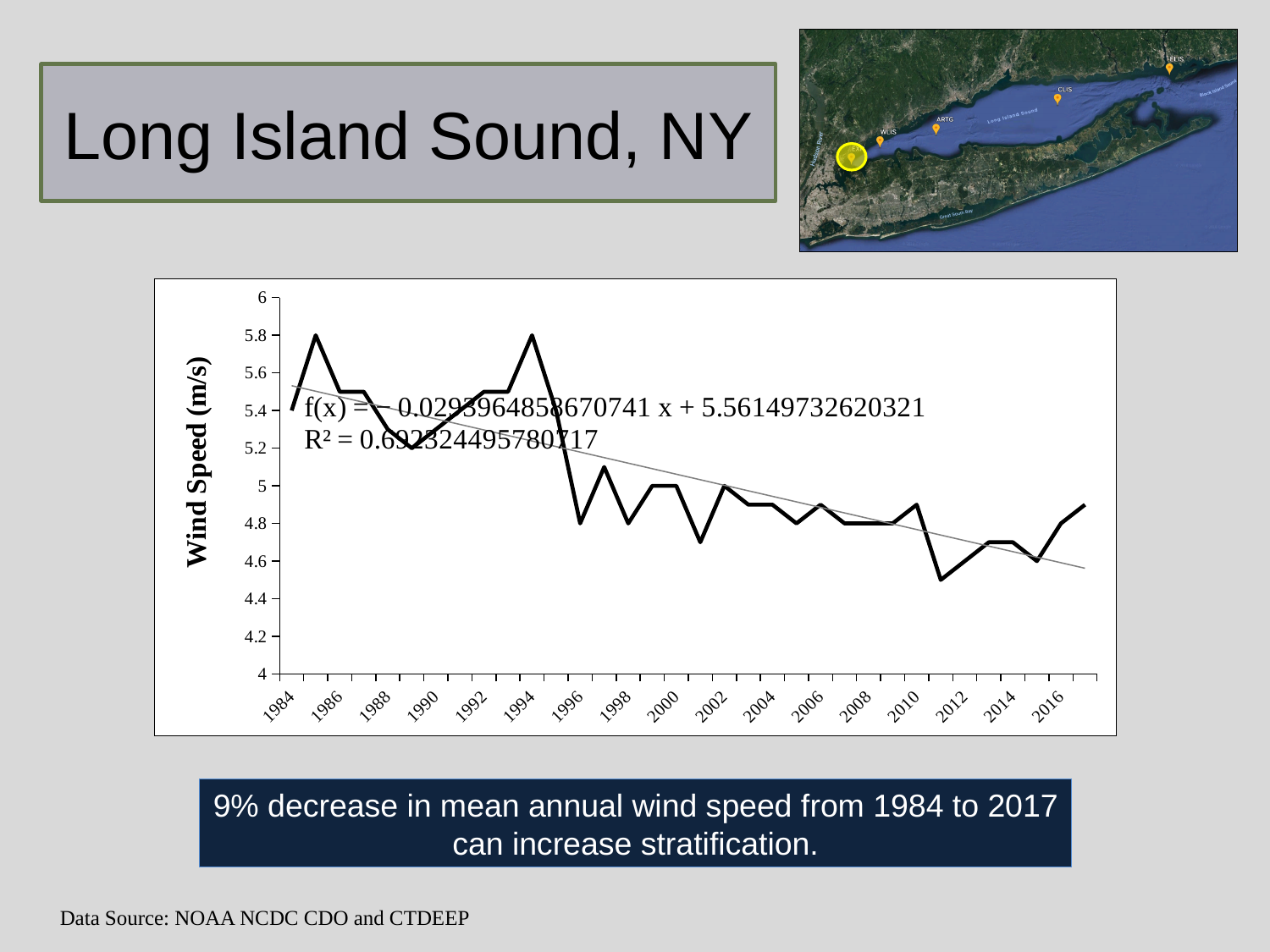
What kind of chart is shown on the slide? line chart Which year has the higher wind speed, 1985 or 2011? 1985 Overall, do the wind speed values rise or fall from 1984 to 2017? fall Which year has the lowest wind speed on the chart? 2011 Is the wind speed for 2016 greater or less than 5? less Is the wind speed for 1985 greater or less than 5.6? greater Is the wind speed for 1989 greater or less than 5? greater Which year has the higher wind speed, 1994 or 2016? 1994 What is the label of the y axis of the chart? Wind Speed (m/s)